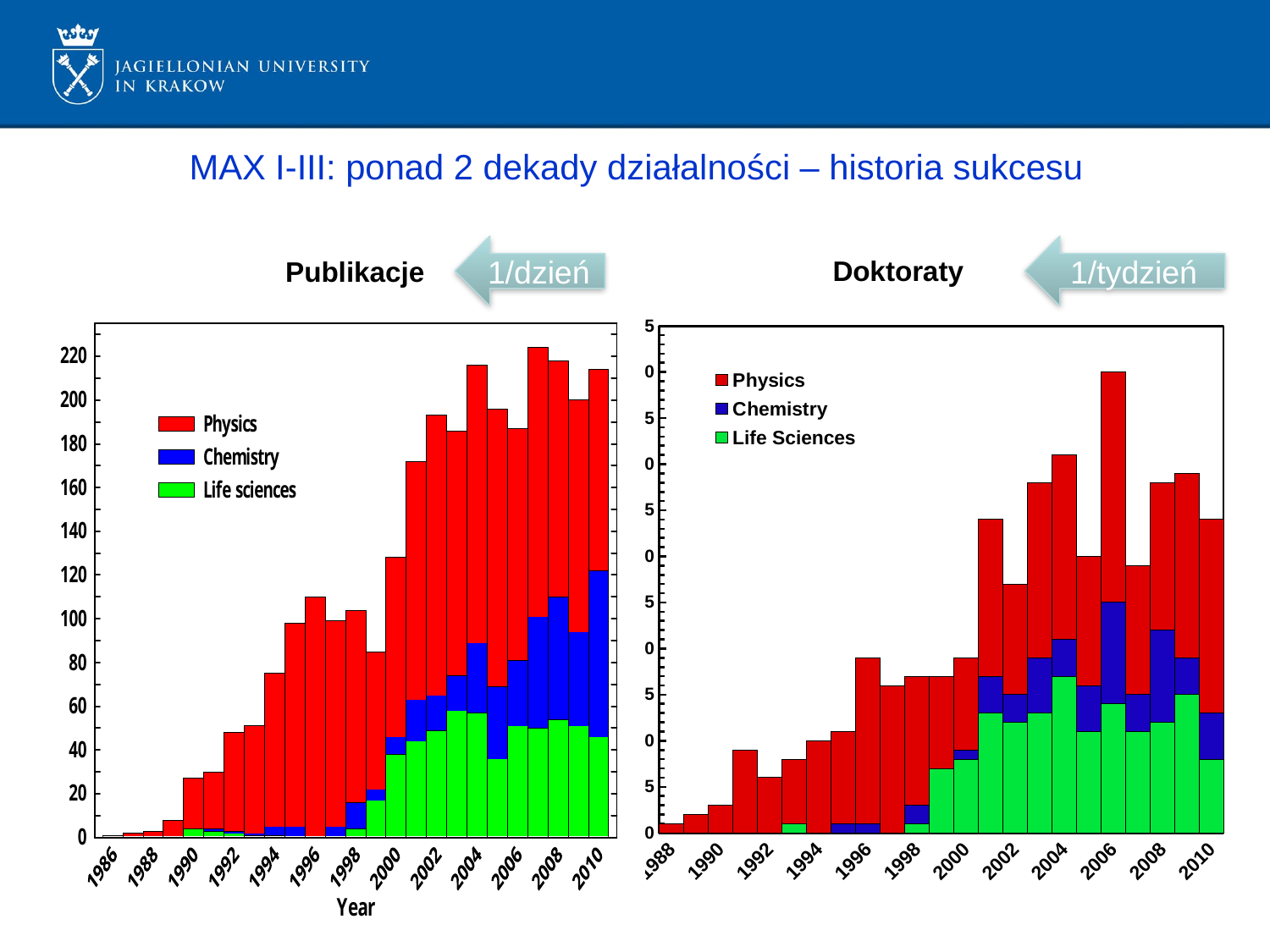
What text is shown in the arrow next to the Publikacje chart title? 1/dzień In the Publikacje chart, is the total value for 2007 greater or less than 200? greater In the Doktoraty chart, which year has the lowest total bar? 1988 How many series does the legend of the Publikacje chart list? 3 In the Publikacje chart, do the total values generally rise or fall from 1986 to 2010? rise Which series are listed in the legend of the Doktoraty chart? Physics, Chemistry, Life Sciences In the Publikacje chart, is the total value for 1996 greater or less than 100? greater What kind of chart is the Publikacje chart on the left? Stacked bar chart In the Publikacje chart, is the total value for 1994 greater or less than 60? greater In the Publikacje chart, which year has the larger total bar, 1994 or 1996? 1996 In the Doktoraty chart, which year has the highest total bar? 2006